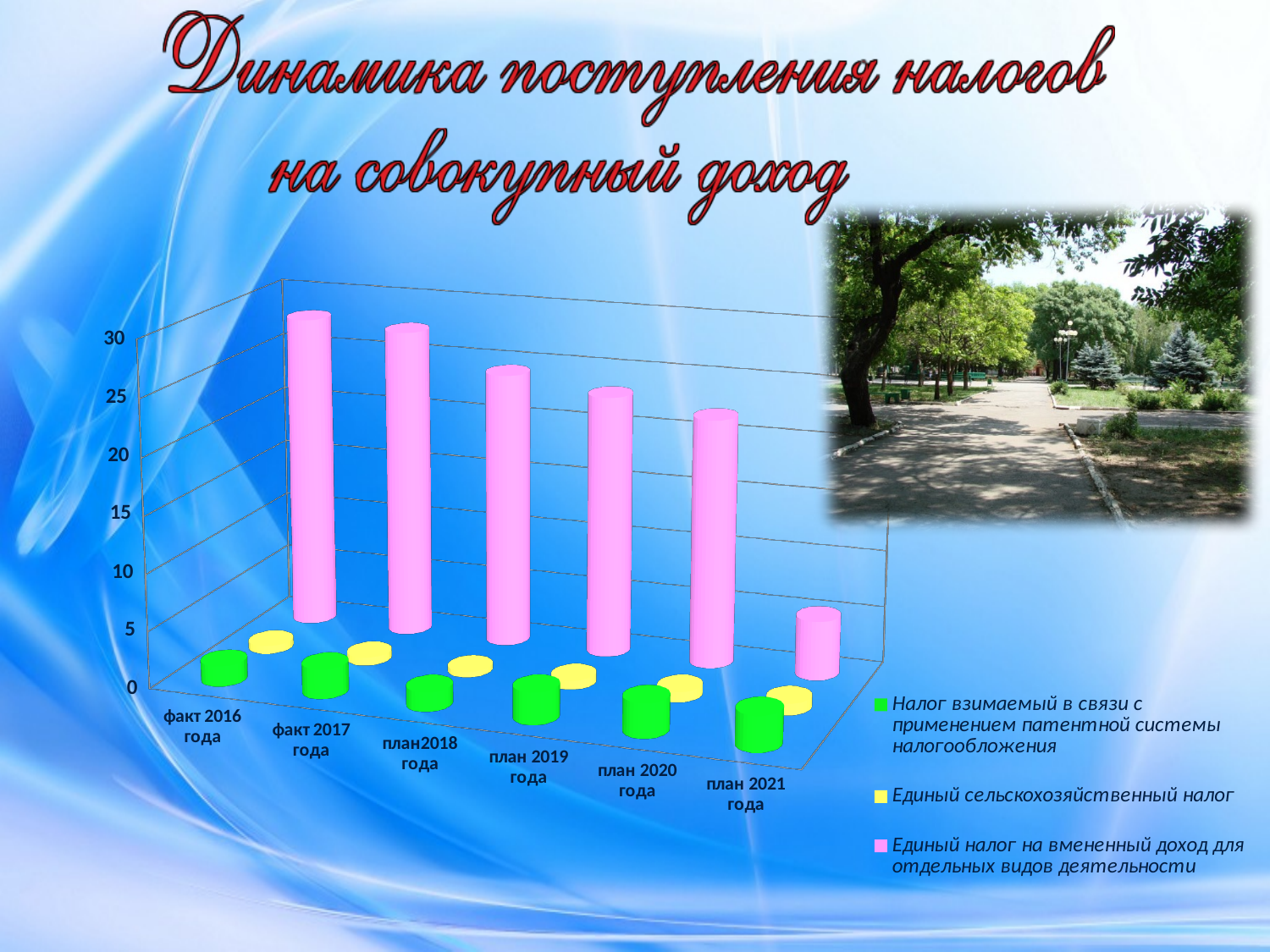
Is the value of the pink series for факт 2016 года greater or less than 25? greater How many categories are shown along the x axis of the chart? 6 What kind of chart is shown on the slide? bar chart What is the title of the slide above the chart? Динамика поступления налогов на совокупный доход For which category is the pink series (Единый налог на вмененный доход) highest? факт 2016 года Which legend entry is shown in pink? Единый налог на вмененный доход для отдельных видов деятельности Is the value of the green series (патентная система) for факт 2016 года greater or less than 10? less Do the values of the pink series (Единый налог на вмененный доход) rise or fall from факт 2016 года to план 2021 года? fall For which category is the pink series (Единый налог на вмененный доход) lowest? план 2021 года Which is larger for план 2019 года: the pink series (Единый налог на вмененный доход) or the green series (Налог взимаемый в связи с применением патентной системы)? pink series (Единый налог на вмененный доход) How many series does the chart legend list? 3 Is the value of the pink series for план 2021 года greater or less than 10? less